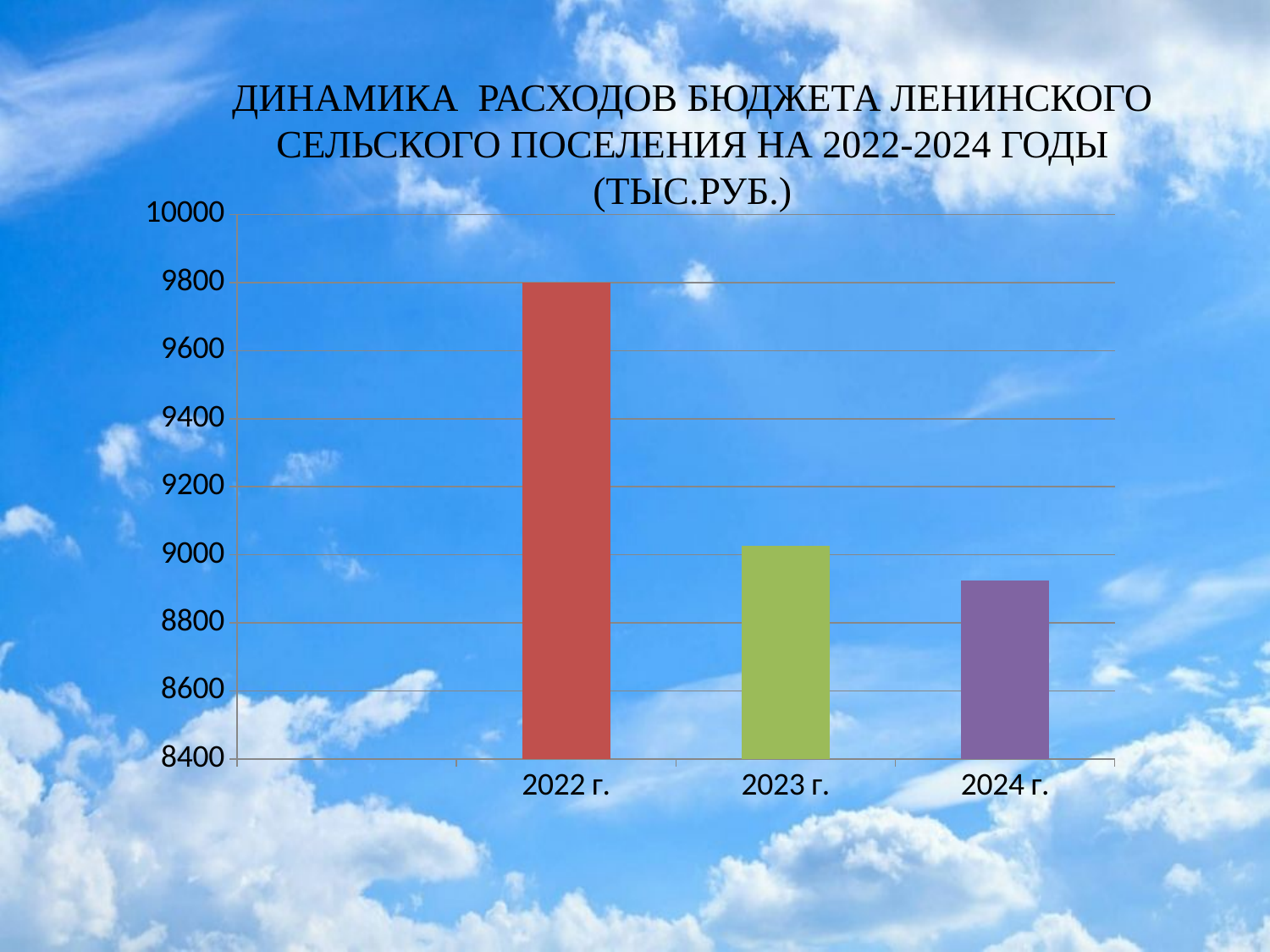
Is the value for 2023 г. greater or less than 9000? greater In what units are the values on the chart expressed, according to the title? тыс.руб. What kind of chart is shown on the slide? bar chart Is the value for 2022 г. greater or less than 9600? greater What colour is the bar for 2022 г.? red Which is larger, the value for 2023 г. or the value for 2024 г.? 2023 г. Which year has the highest budget expenditure on the chart? 2022 г. Is the value for 2024 г. greater or less than 8800? greater How many years (categories) are plotted on the chart? 3 Do the values rise or fall from 2022 г. to 2024 г.? fall Which year has the lowest budget expenditure on the chart? 2024 г.